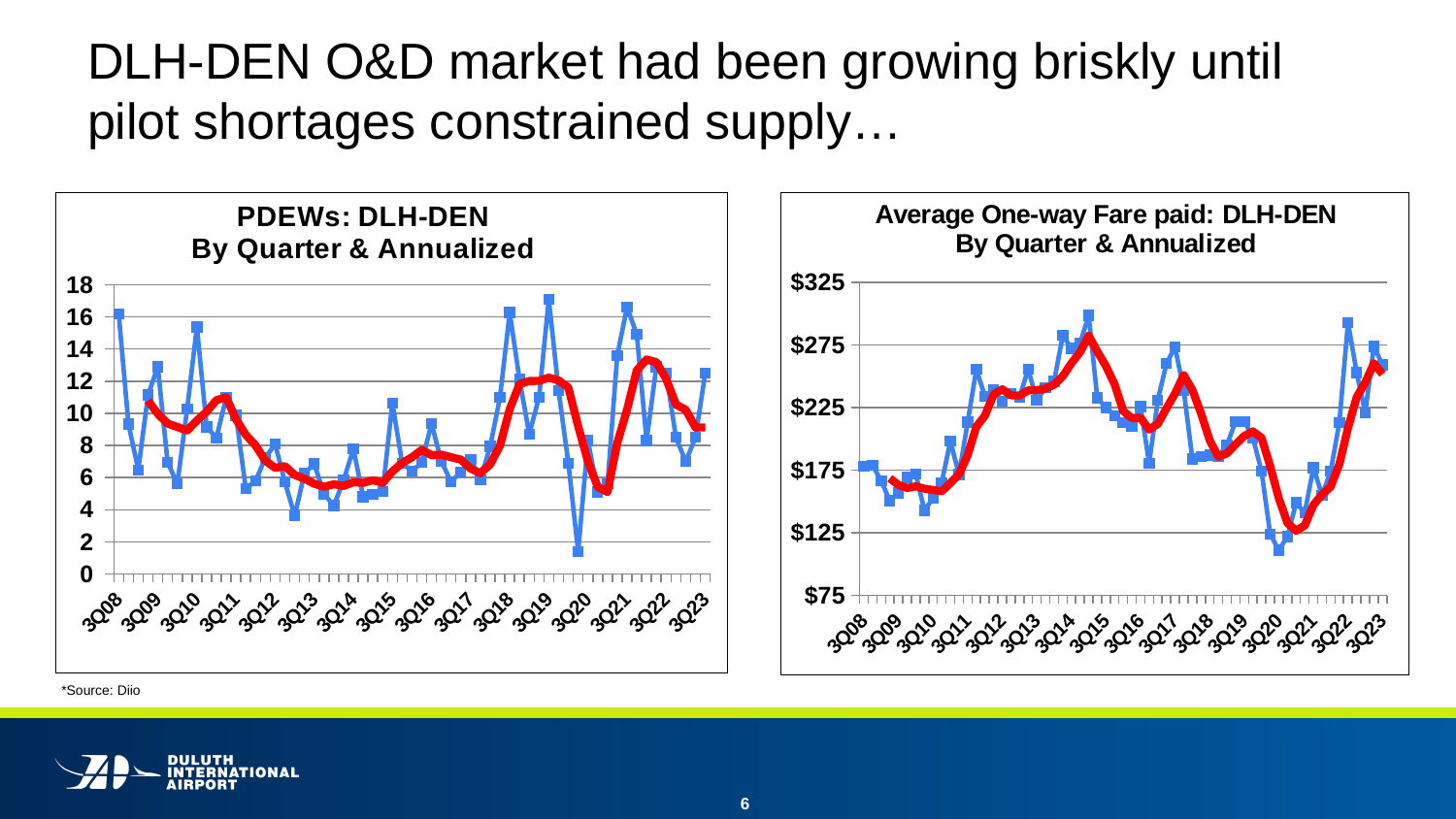
What kind of chart is the left chart titled "PDEWs: DLH-DEN By Quarter & Annualized"? line chart In the left chart (PDEWs), is the value for 3Q08 greater or less than 14? greater What kind of chart is the right chart titled "Average One-way Fare paid: DLH-DEN By Quarter & Annualized"? line chart In the right chart (Average One-way Fare), does the red annualized line rise or fall between 3Q20 and 3Q22? rise What is the title of the right chart? Average One-way Fare paid: DLH-DEN By Quarter & Annualized In the right chart (Average One-way Fare), is the value for 3Q08 greater or less than $125? greater In the left chart (PDEWs), how many quarter labels are shown on the x axis? 16 In the right chart (Average One-way Fare), does the red annualized line rise or fall between 3Q19 and 3Q20? fall In the right chart (Average One-way Fare), is the lowest value near 3Q20 greater or less than $125? less In the right chart (Average One-way Fare), at which x-axis label does the blue quarterly line reach its lowest point? 3Q20 In the left chart (PDEWs), at which x-axis label does the blue quarterly line reach its lowest point? 3Q20